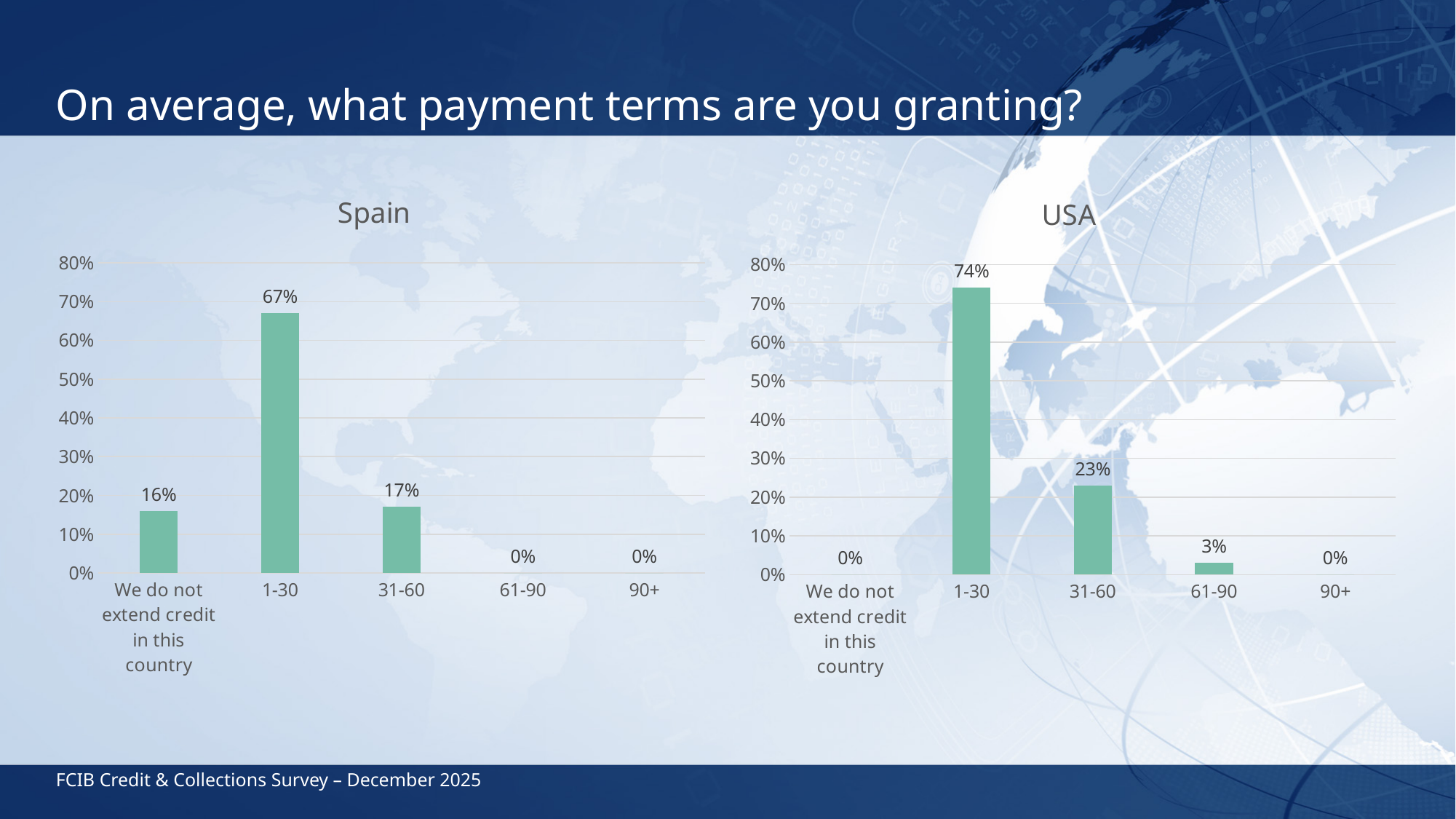
In the USA chart, what is the value for 61-90? 3% What kind of chart is the USA chart? Bar chart In the Spain chart, what is the value for 1-30? 67% In the USA chart, what is the value for 31-60? 23% In the USA chart, which category has the highest value? 1-30 In the USA chart, what is the difference between the values for 1-30 and 31-60? 51% Which is larger: the value for 1-30 in the Spain chart or the value for 1-30 in the USA chart? USA In the Spain chart, what is the value for 'We do not extend credit in this country'? 16% What is the title of the chart on the left side of the slide? Spain In the Spain chart, which category has the highest value? 1-30 In the Spain chart, what is the difference between the values for 1-30 and 31-60? 50% How many categories are shown on the x axis of the Spain chart? 5